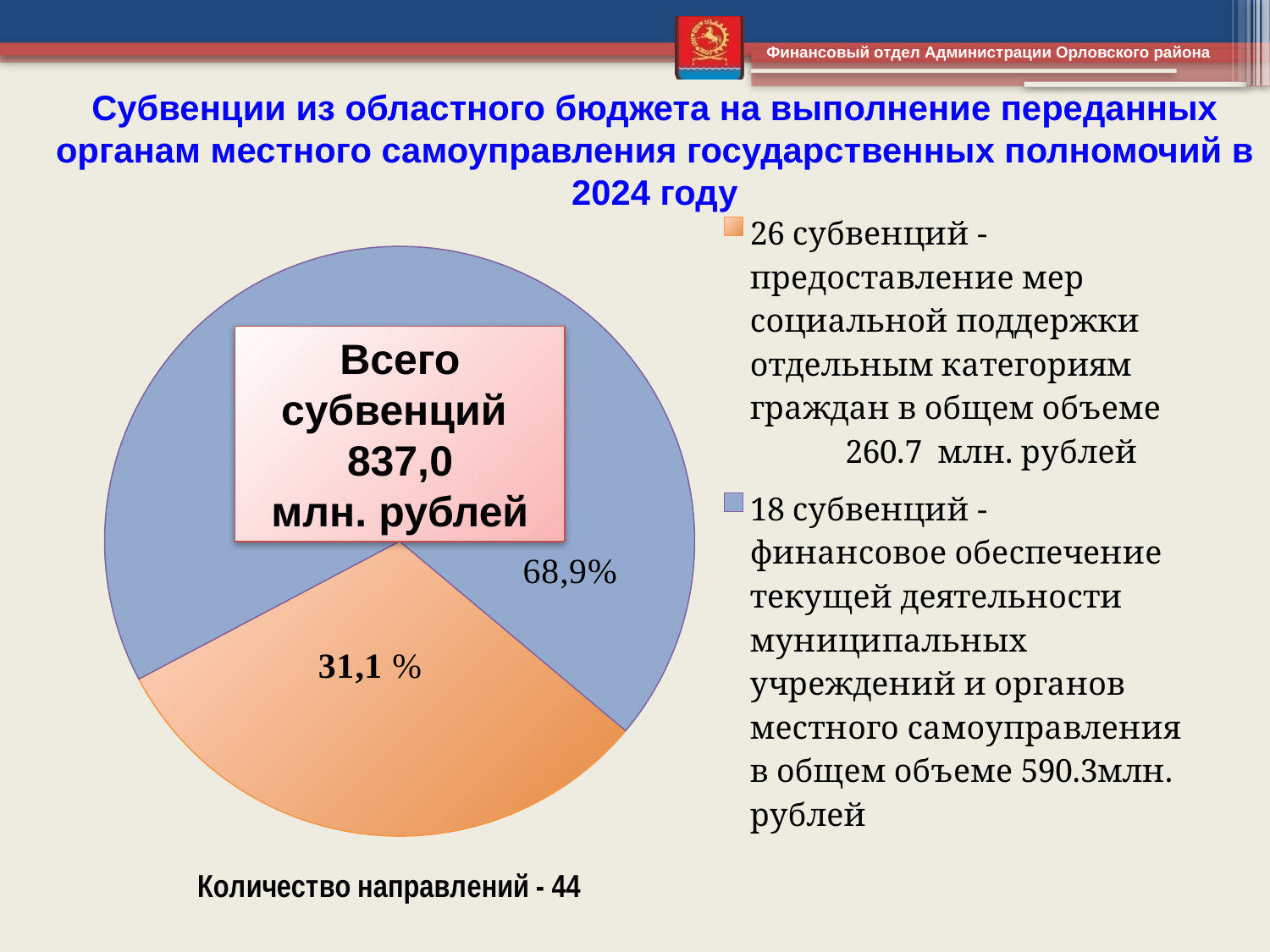
How many slices does the pie chart have? 2 How many series (categories) does the legend list? 2 What is the total volume of the 26 subventions for social support measures, according to the legend? 260.7 млн. рублей Which slice of the pie is larger, the blue one or the orange one? the blue one What kind of chart is shown on the slide? pie chart Which category has the largest share of the pie? финансовое обеспечение текущей деятельности муниципальных учреждений и органов местного самоуправления (18 субвенций) What is the total amount of subventions shown in the centre of the pie chart? 837,0 млн. рублей What number of directions (Количество направлений) is stated below the pie chart? 44 Which category has the smallest share of the pie? предоставление мер социальной поддержки отдельным категориям граждан (26 субвенций) What is the total volume of the 18 subventions for financial support of municipal institutions, according to the legend? 590.3 млн. рублей What share of the pie is the orange slice (social support subventions)? 31,1 % What share of the pie is the blue slice (financial support of municipal institutions)? 68,9%